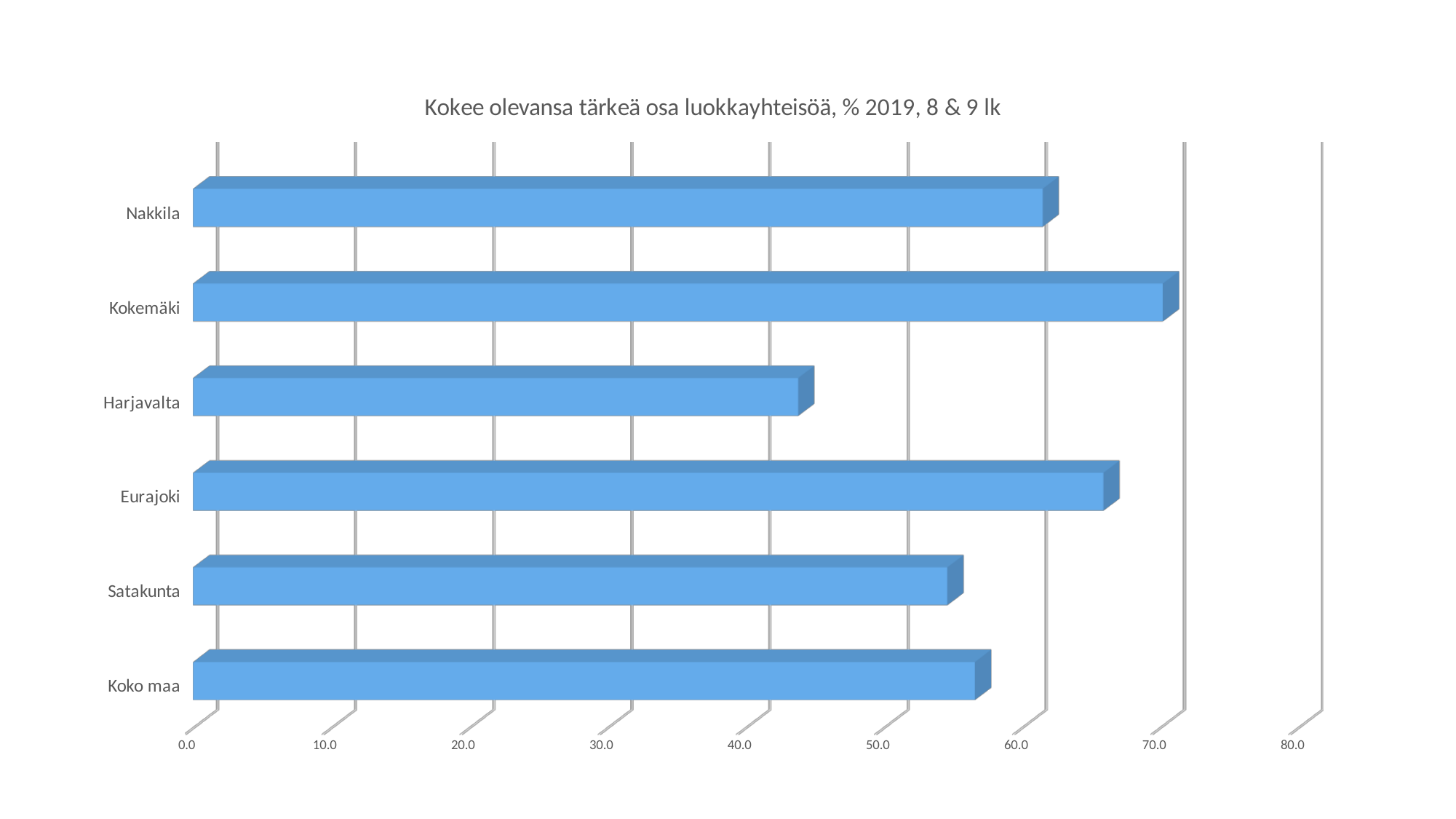
Is the value for Satakunta greater or less than 60.0? less What kind of chart is shown on the slide? bar chart Is the value for Harjavalta greater or less than 40.0? greater Which has the larger value, Kokemäki or Eurajoki? Kokemäki Is the value for Kokemäki greater or less than 60.0? greater How many categories are plotted in the chart? 6 Which has the larger value, Eurajoki or Nakkila? Eurajoki Which category has the highest value? Kokemäki What is the title of the chart? Kokee olevansa tärkeä osa luokkayhteisöä, % 2019, 8 & 9 lk Which category has the lowest value? Harjavalta